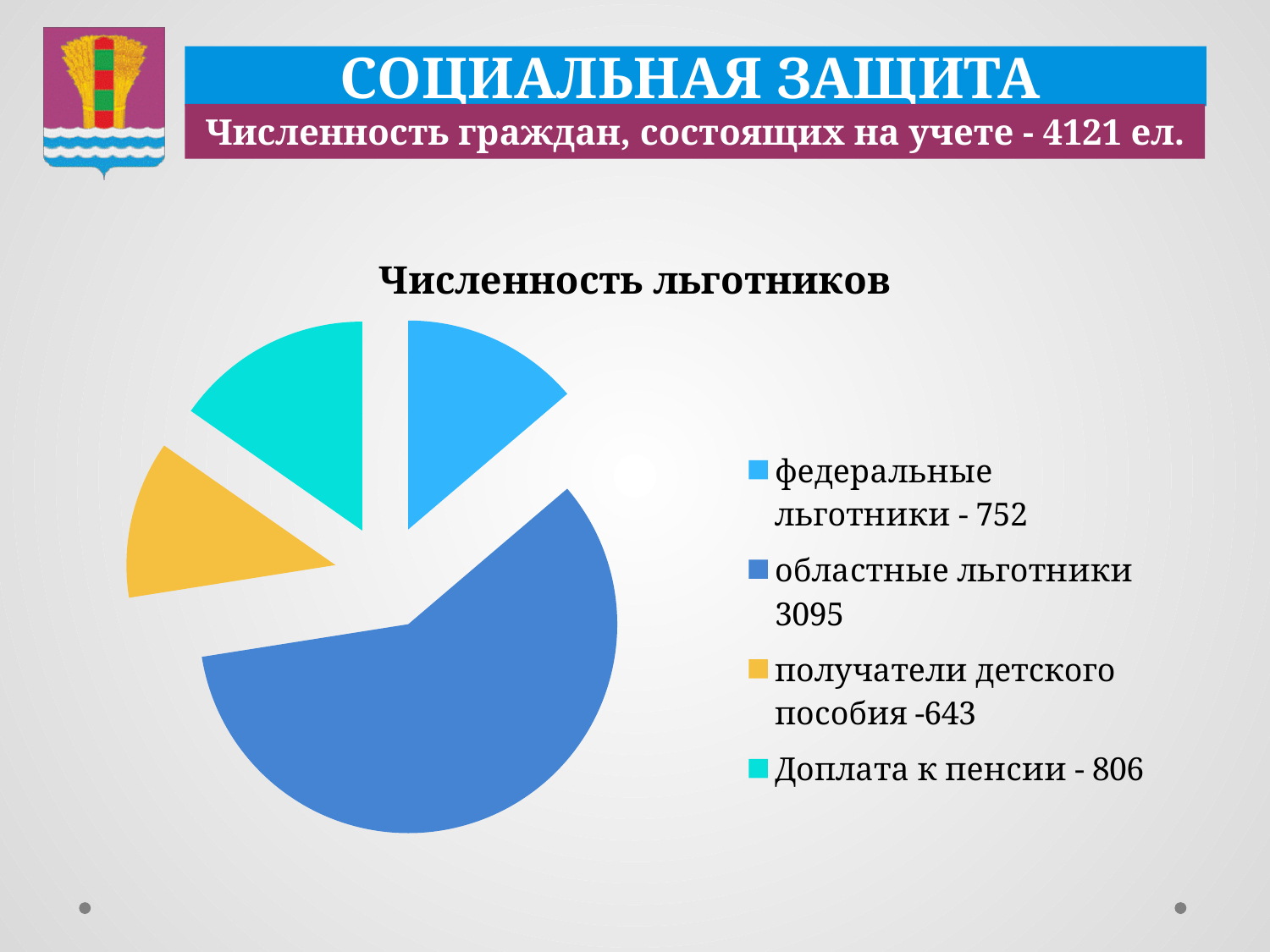
What is the title of the chart? Численность льготников Which category has the largest slice of the pie? областные льготники Which category has the smallest slice of the pie? получатели детского пособия What is the value for Доплата к пенсии? 806 How many slices does the pie chart have? 4 What is the value for областные льготники? 3095 What is the value for получатели детского пособия? 643 What kind of chart is shown on the slide? pie chart What is the difference between областные льготники and федеральные льготники? 2343 What colour is the slice for областные льготники? dark blue What is the value for федеральные льготники? 752 Which is larger, Доплата к пенсии or федеральные льготники? Доплата к пенсии